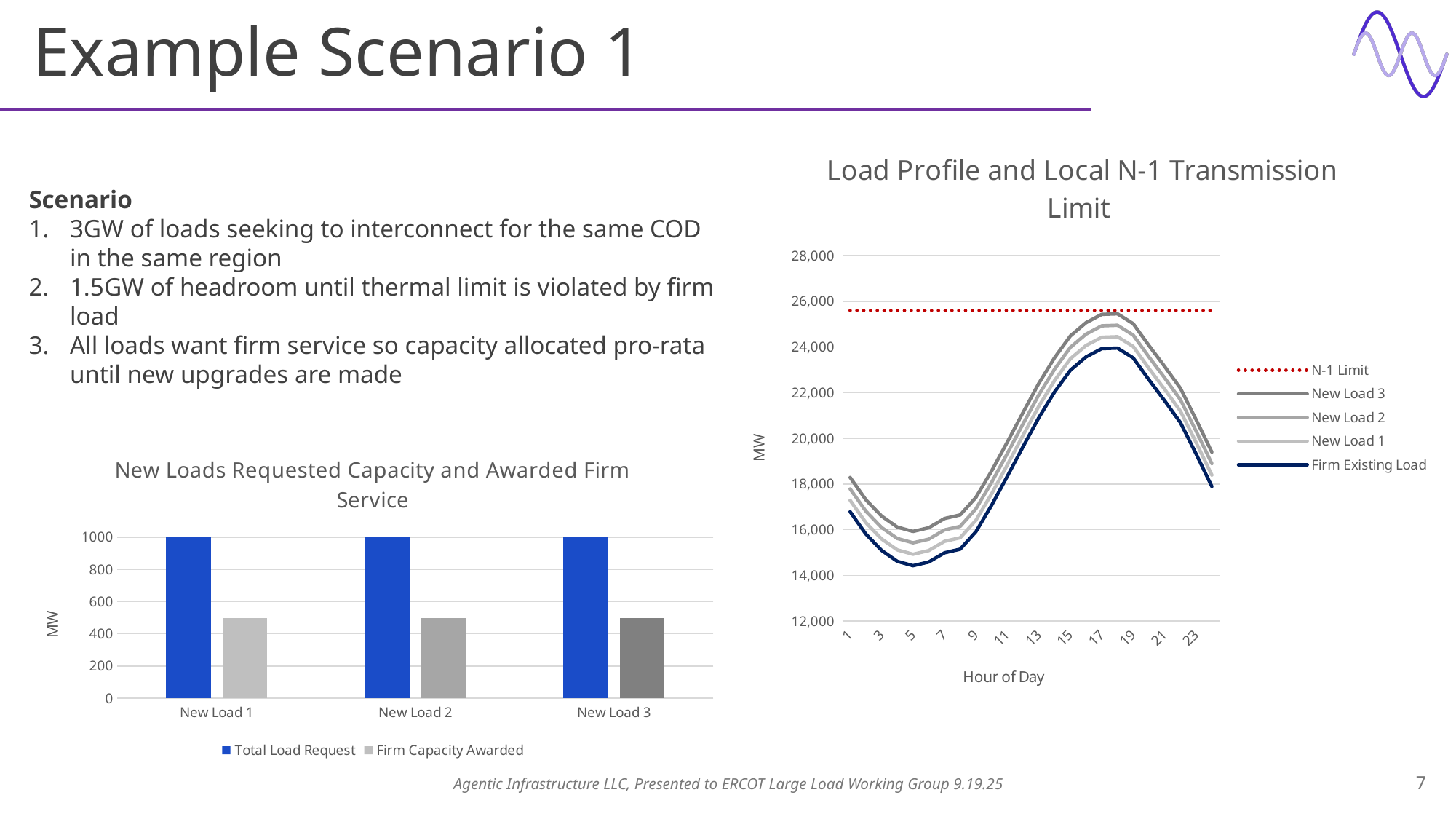
What kind of chart is the one titled 'New Loads Requested Capacity and Awarded Firm Service'? bar chart On the chart titled 'New Loads Requested Capacity and Awarded Firm Service', is the Firm Capacity Awarded for New Load 1 greater or less than 400? greater On the chart titled 'Load Profile and Local N-1 Transmission Limit', how many series does the legend list? 5 On the chart titled 'Load Profile and Local N-1 Transmission Limit', is the Firm Existing Load at hour 5 greater or less than 16,000? less On the chart titled 'New Loads Requested Capacity and Awarded Firm Service', which is larger for New Load 1: Total Load Request or Firm Capacity Awarded? Total Load Request On the chart titled 'New Loads Requested Capacity and Awarded Firm Service', how many categories are shown on the x axis? 3 On the chart titled 'New Loads Requested Capacity and Awarded Firm Service', is the Firm Capacity Awarded for New Load 3 greater or less than 600? less What kind of chart is the one titled 'Load Profile and Local N-1 Transmission Limit'? line chart On the chart titled 'New Loads Requested Capacity and Awarded Firm Service', what is the Total Load Request for New Load 2? 1000 On the chart titled 'New Loads Requested Capacity and Awarded Firm Service', how many series does the legend list? 2 On the chart titled 'Load Profile and Local N-1 Transmission Limit', does the Firm Existing Load rise or fall between hour 5 and hour 17? rise